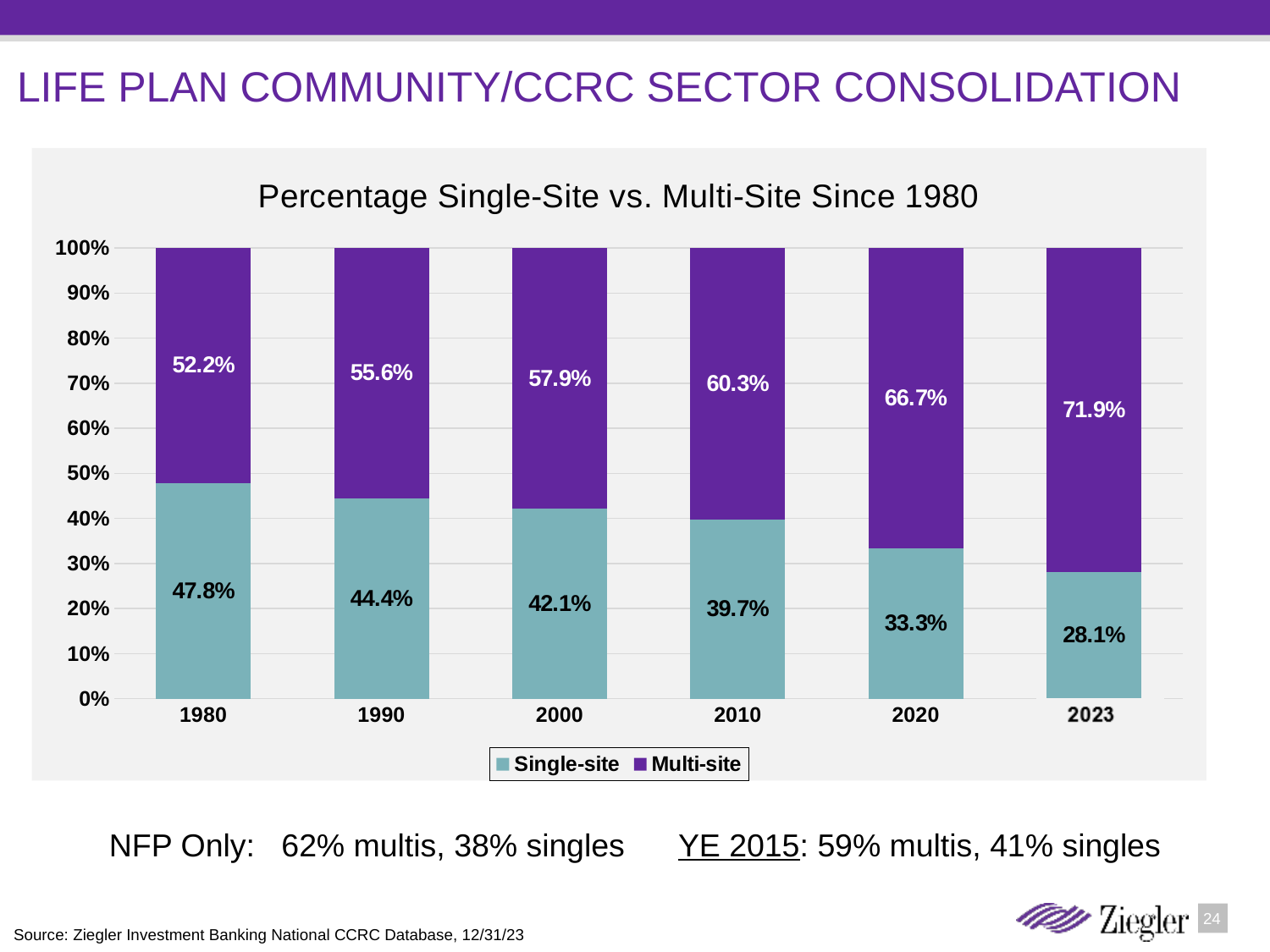
How many series does the legend list? 2 What is the Multi-site percentage for 2023? 71.9% Which is larger in 1990, the Single-site or the Multi-site percentage? Multi-site What is the title of the chart? Percentage Single-Site vs. Multi-Site Since 1980 Which year has the lowest Single-site percentage? 2023 What is the difference between the Multi-site and Single-site percentages in 2020? 33.4% Does the Single-site percentage rise or fall from 1980 to 2023? Fall Which year has the highest Multi-site percentage? 2023 What is the Single-site percentage for 1980? 47.8% What is the Multi-site percentage for 2010? 60.3% How many years are shown on the x axis? 6 What kind of chart is shown? Stacked bar chart